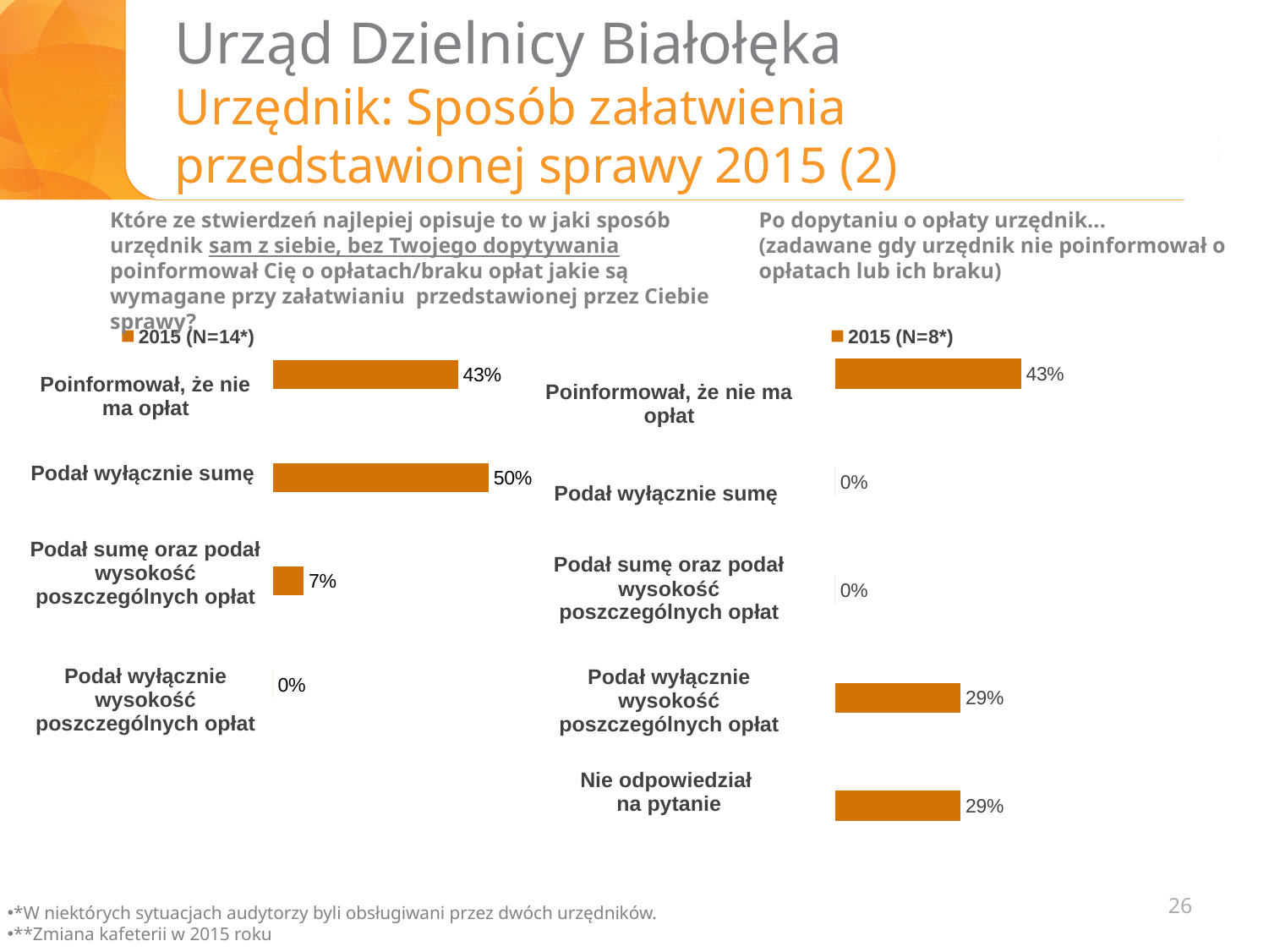
What type of chart is used on the left side of the slide? Bar chart In the right chart (2015, N=8), which category has the highest value? Poinformował, że nie ma opłat In the right chart (2015, N=8), which is larger: "Poinformował, że nie ma opłat" or "Podał wyłącznie wysokość poszczególnych opłat"? Poinformował, że nie ma opłat In the left chart (2015, N=14), what is the value for "Podał wyłącznie sumę"? 50% How many categories are shown in the left chart (2015, N=14)? 4 In the right chart (2015, N=8), what is the value for "Nie odpowiedział na pytanie"? 29% In the left chart (2015, N=14), which category has the highest value? Podał wyłącznie sumę In the right chart (2015, N=8), what is the value for "Poinformował, że nie ma opłat"? 43% How many categories are shown in the right chart (2015, N=8)? 5 In the left chart (2015, N=14), what is the difference between "Podał wyłącznie sumę" and "Poinformował, że nie ma opłat"? 7% In the left chart (2015, N=14), which category has the lowest value? Podał wyłącznie wysokość poszczególnych opłat In the left chart (2015, N=14), what is the value for "Podał sumę oraz podał wysokość poszczególnych opłat"? 7%